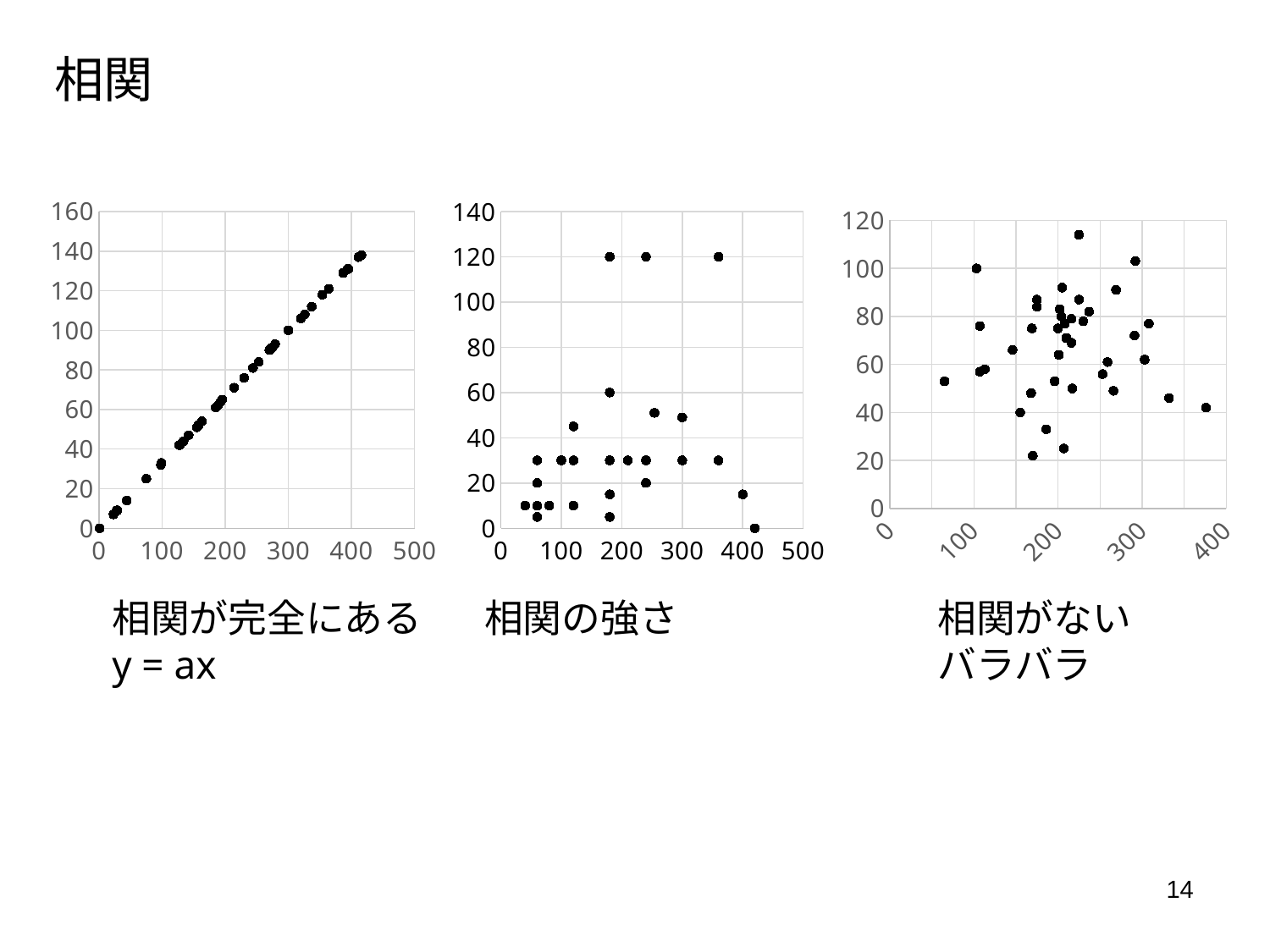
What kind of chart is the left chart on the slide? scatter chart What is the maximum value shown on the x axis of the right chart? 400 In the middle chart (相関の強さ), is the y value of the highest points greater or less than 100? greater In the right chart, is the y value of the lowest point greater or less than 40? less What is the maximum value shown on the y axis of the left chart? 160 How many charts are shown on the slide? 3 In the middle chart, is the y value of the point at x = 420 greater or less than 20? less What kind of chart is the right chart on the slide? scatter chart In the left chart (相関が完全にある), do the y values rise or fall as x increases? rise